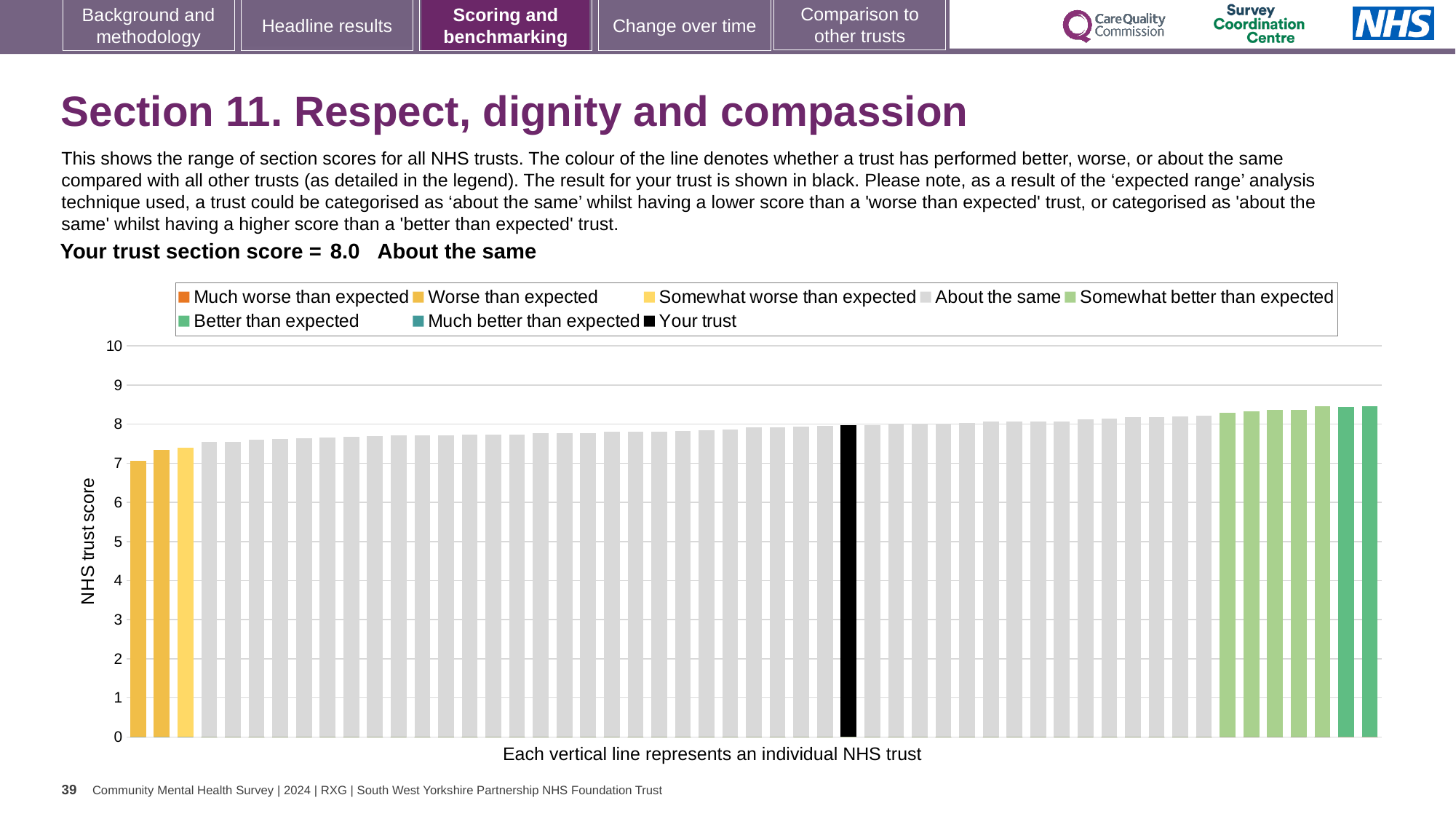
What is the section score for your trust shown on the slide? 8.0 Do the bar values rise or fall from left to right across the chart? rise Which category is your trust's section score placed in? About the same How many entries does the chart legend list? 8 Is the value of the rightmost (highest) bar greater or less than 8? greater What is the label on the vertical axis of the chart? NHS trust score What kind of chart is shown on the slide? bar chart Is the value of the leftmost (lowest) bar greater or less than 8? less What colour is the bar representing your trust? black How many bars are coloured in the dark green 'Better than expected' shade? 2 Is the value of the rightmost (highest) bar greater or less than 9? less Which is larger: the score of your trust (black bar) or the score of the leftmost bar? your trust